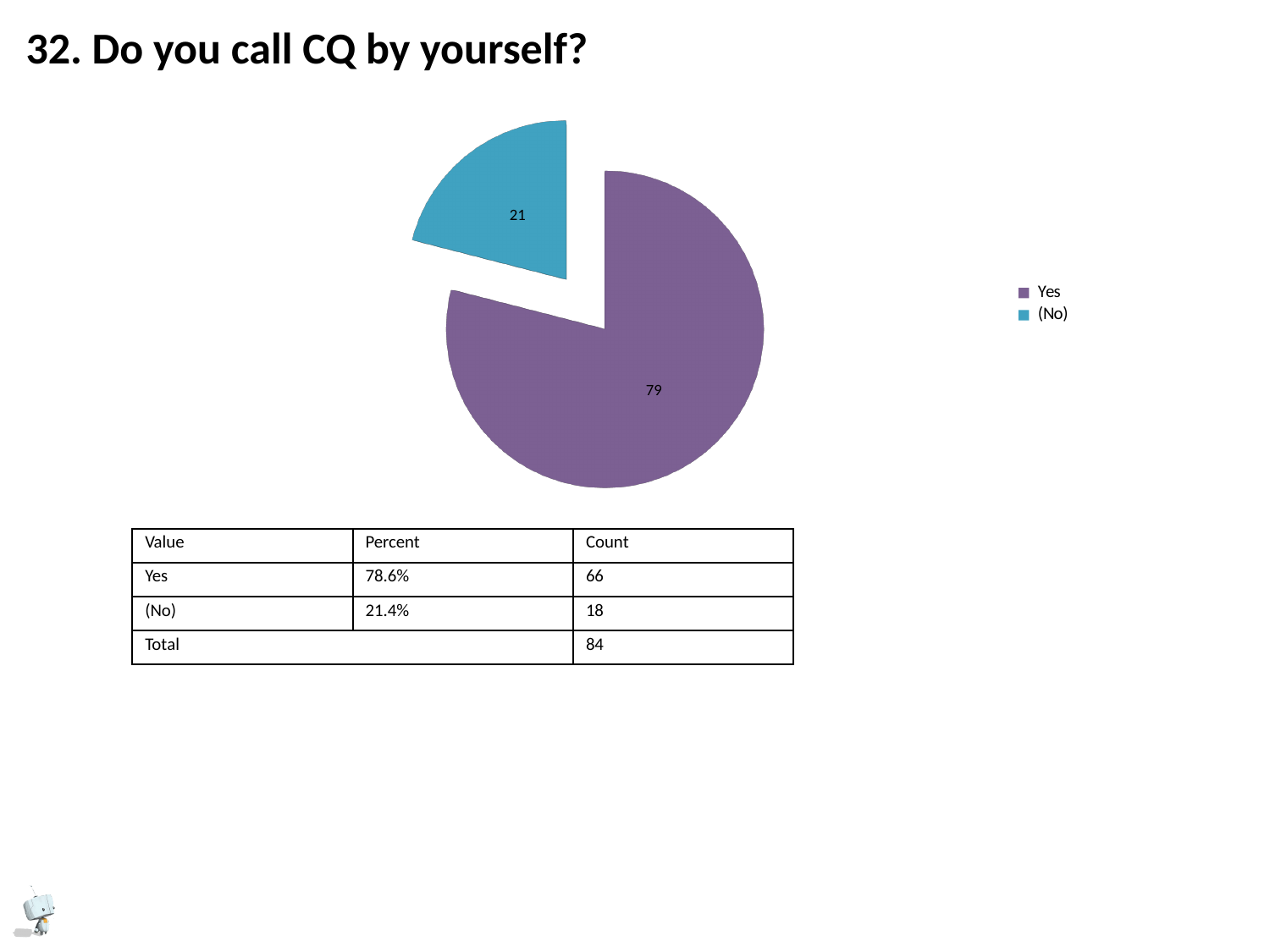
How many slices does the pie chart have? 2 Is the data label for the Yes slice greater or less than 50? greater What kind of chart is shown on the slide? pie chart How many entries does the legend list? 2 What is the data label on the Yes slice of the pie chart? 79 Which slice is larger, Yes or (No)? Yes What is the data label on the (No) slice of the pie chart? 21 What is the title of the slide containing the pie chart? 32. Do you call CQ by yourself? What is the difference between the Yes and (No) data labels on the pie chart? 58 What colour is the Yes slice of the pie chart? purple Which slice of the pie chart is the smallest? (No) Which slice of the pie chart is the largest? Yes